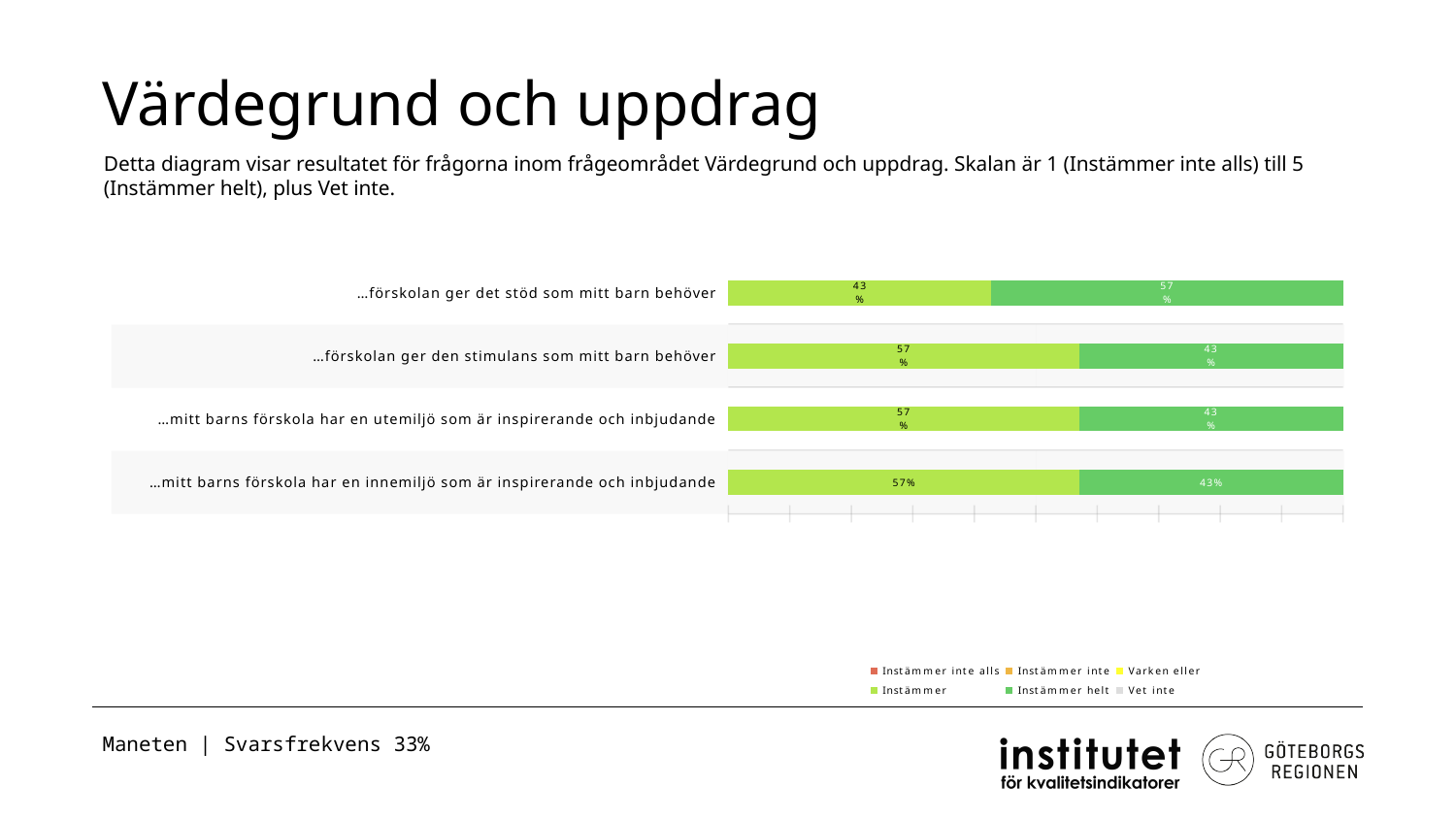
Which category has the highest 'Instämmer helt' value? …förskolan ger det stöd som mitt barn behöver What is the 'Instämmer helt' value for '…förskolan ger det stöd som mitt barn behöver'? 57% For '…förskolan ger det stöd som mitt barn behöver', which is larger: 'Instämmer' or 'Instämmer helt'? Instämmer helt What is the 'Instämmer helt' value for '…mitt barns förskola har en innemiljö som är inspirerande och inbjudande'? 43% What kind of chart is shown on the slide? stacked bar chart What is the difference between the 'Instämmer helt' and 'Instämmer' values for '…mitt barns förskola har en utemiljö som är inspirerande och inbjudande'? 14% How many series does the legend list? 6 What is the total of the stacked bar for '…förskolan ger den stimulans som mitt barn behöver'? 100% What is the 'Instämmer' value for '…förskolan ger det stöd som mitt barn behöver'? 43% What is the 'Instämmer' value for '…förskolan ger den stimulans som mitt barn behöver'? 57% Which category has the lowest 'Instämmer' value? …förskolan ger det stöd som mitt barn behöver How many categories (questions) are plotted in the chart? 4